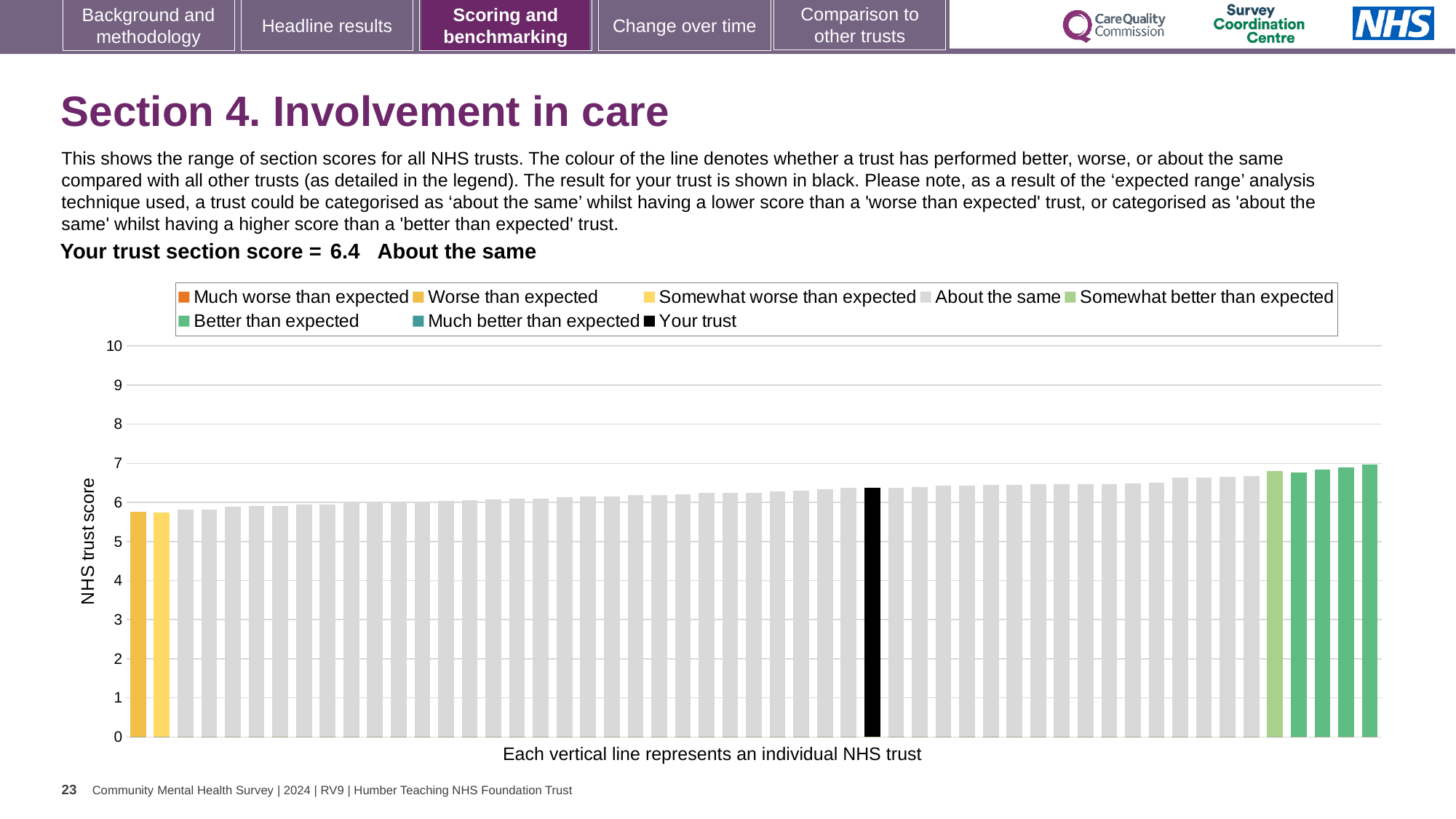
How many bars are coloured as 'Better than expected' (green)? 4 What kind of chart is shown on the slide? bar chart Is the value of the leftmost bar greater or less than 6? less What is the section score for your trust shown on the slide? 6.4 Do the bar values rise or fall from left to right along the x axis? rise Is the value for your trust (the black bar) greater or less than 6? greater How many entries does the chart legend list? 8 Is the value for your trust (the black bar) greater or less than 7? less What is the label on the y axis of the chart? NHS trust score How many bars are coloured as 'Worse than expected' (yellow)? 1 Which performance category is your trust's section score assigned to? About the same